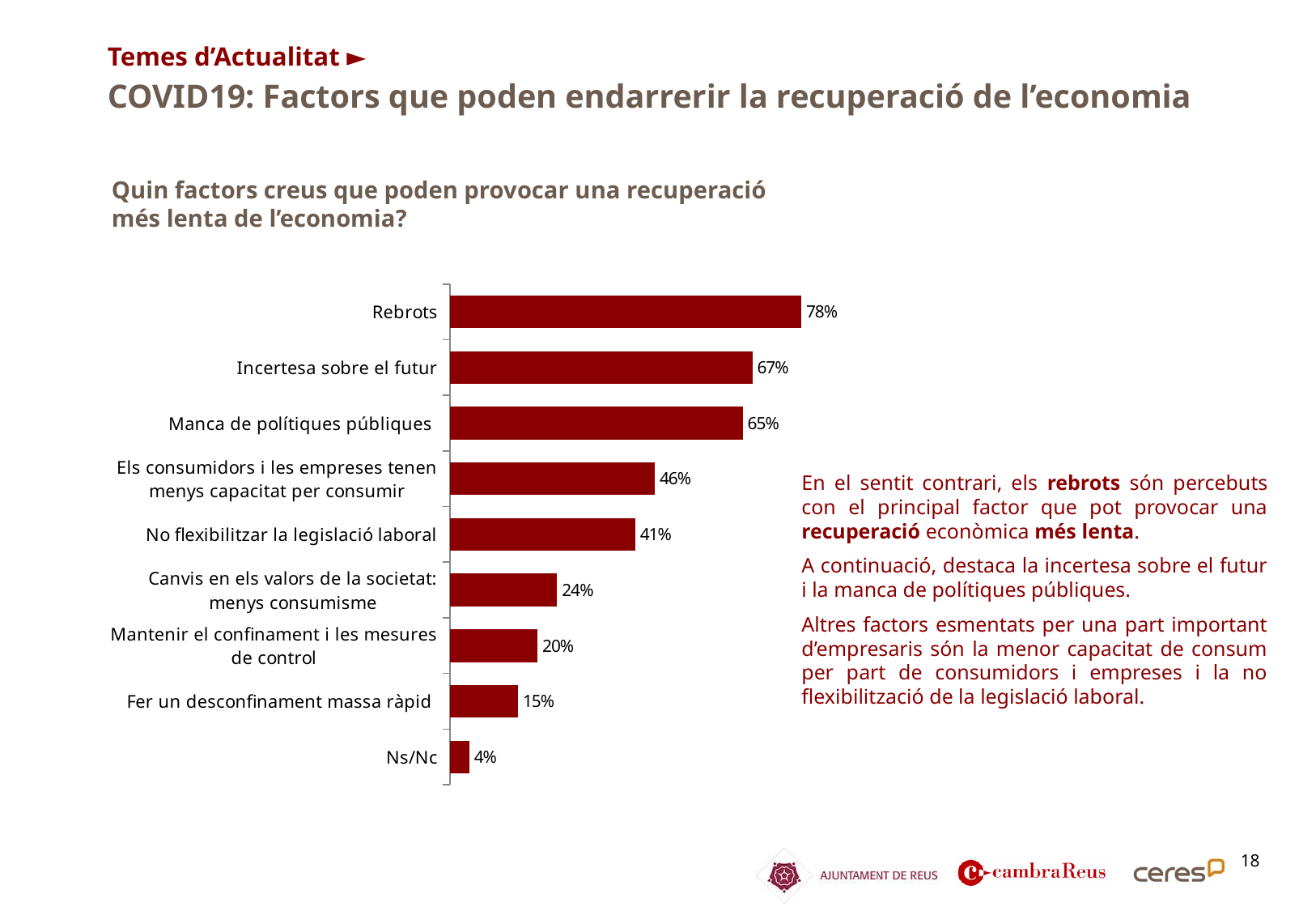
What is the difference between "Incertesa sobre el futur" and "Manca de polítiques públiques"? 2% Which is larger: "Canvis en els valors de la societat: menys consumisme" or "Mantenir el confinament i les mesures de control"? Canvis en els valors de la societat: menys consumisme Which category has the highest value? Rebrots What is the difference between "Rebrots" and "Els consumidors i les empreses tenen menys capacitat per consumir"? 32% What colour are the bars in the chart? Dark red What kind of chart is shown on the slide? Bar chart What percentage is shown for "Rebrots"? 78% Which category has the lowest value? Ns/Nc How many categories are shown in the chart? 9 What is the value for "No flexibilitzar la legislació laboral"? 41% What is the value for "Ns/Nc"? 4% What percentage is shown for "Fer un desconfinament massa ràpid"? 15%